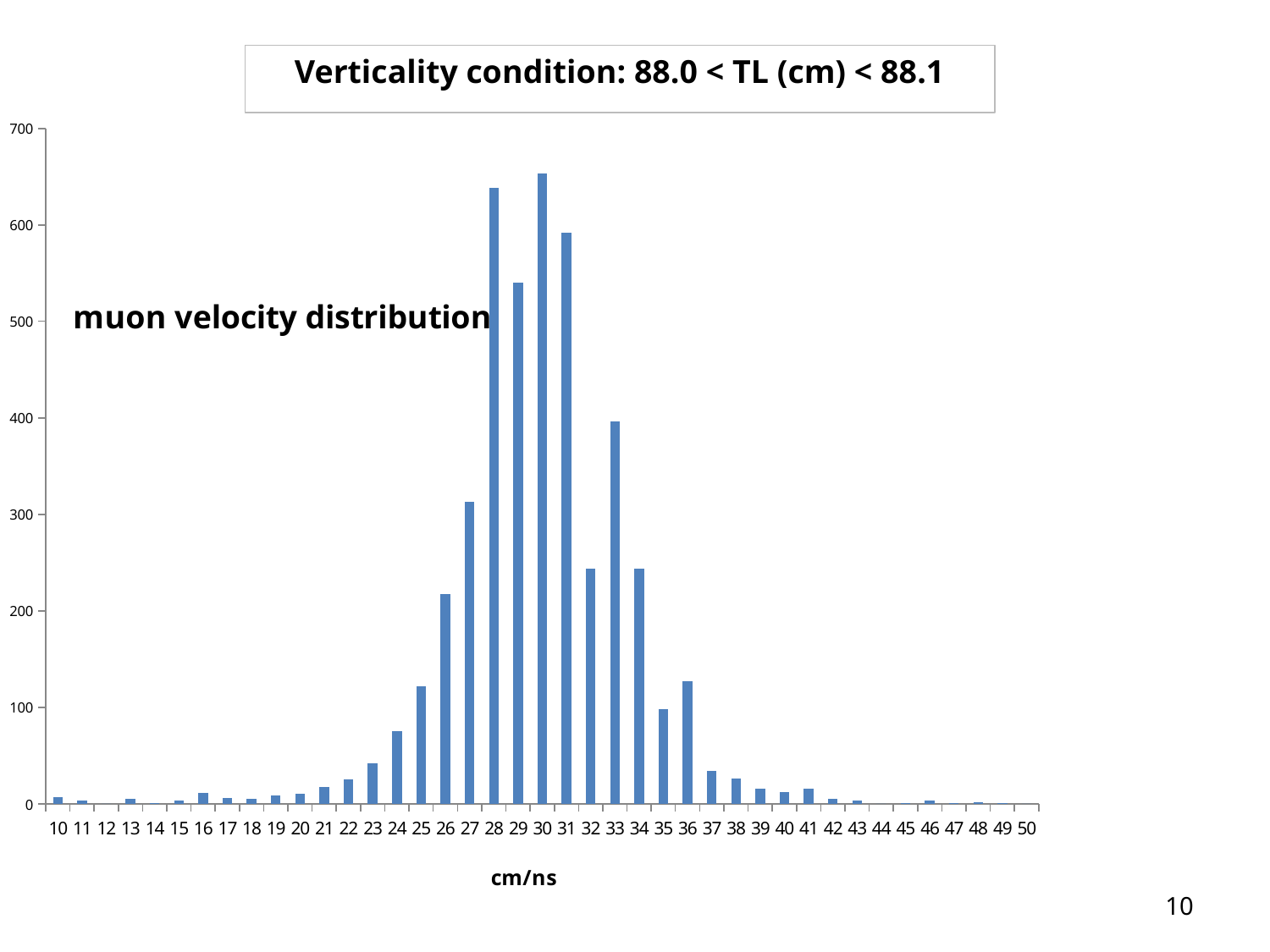
Do the values generally rise or fall along the x axis from 30 cm/ns to 50 cm/ns? fall Is the value for the 24 cm/ns bin greater or less than 100? less What is the label on the x axis of the chart? cm/ns How many velocity bins are labelled on the x axis? 41 Is the value for the 30 cm/ns bin greater or less than 600? greater Which bin has the larger value, 33 cm/ns or 34 cm/ns? 33 Which bin has the larger value, 28 cm/ns or 29 cm/ns? 28 Is the value for the 26 cm/ns bin greater or less than 200? greater Which velocity bin (cm/ns) has the highest count? 30 What kind of chart is shown on the slide? bar chart